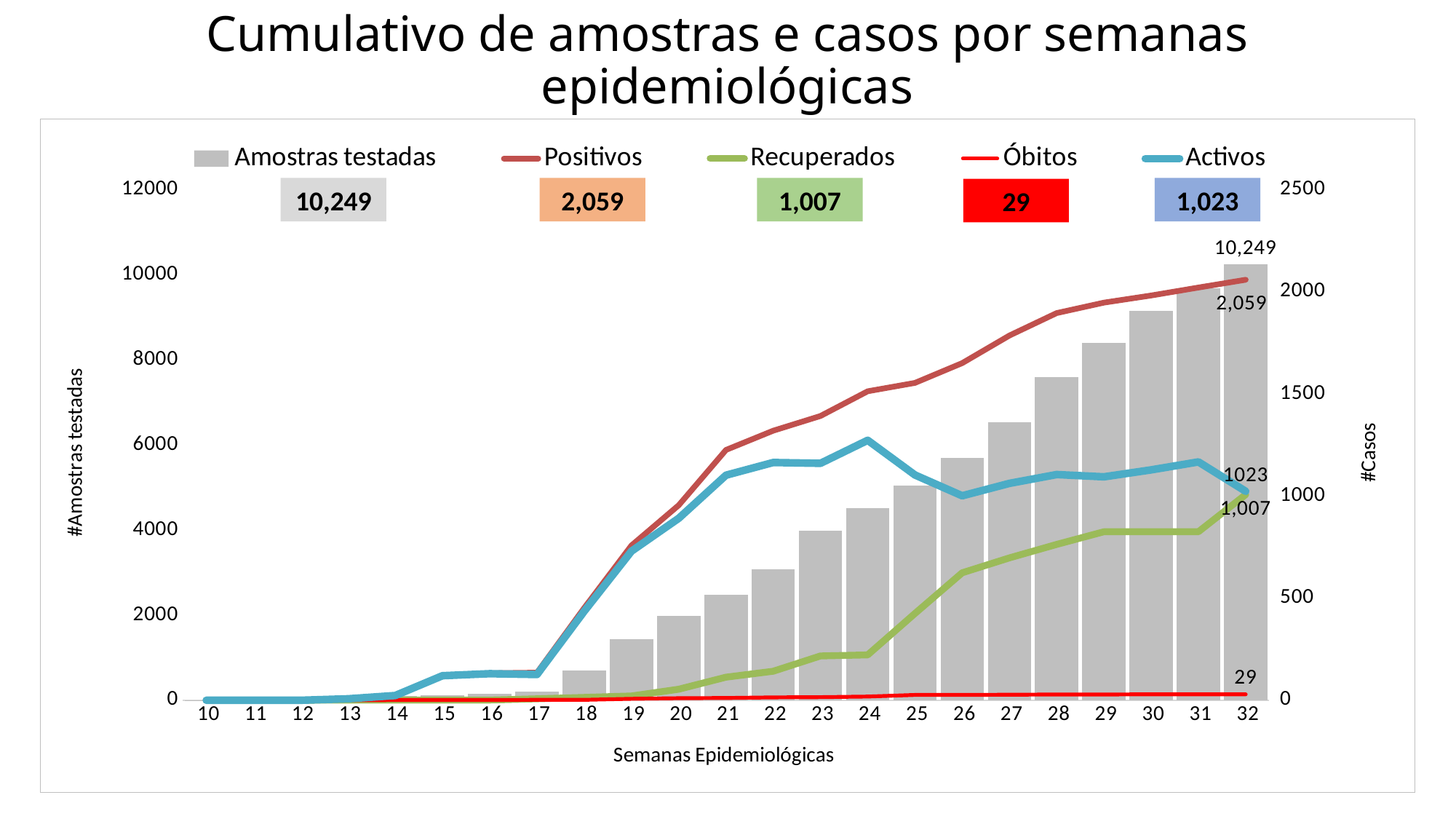
Do the Amostras testadas bars rise or fall from week 10 to week 32? Rise What is the difference between Positivos and Recuperados at week 32? 1,052 Is the value of Amostras testadas at week 25 greater or less than 4000? greater How many series does the legend list? 5 What is the value of Recuperados at week 32? 1,007 What is the value of Óbitos at week 32? 29 What is the value of Amostras testadas at week 32? 10,249 What is the difference between Amostras testadas and Positivos at week 32? 8,190 How many epidemiological weeks are shown on the x axis? 23 At week 32, which is larger: Positivos or Recuperados? Positivos What kind of chart is this? Combined bar and line chart What is the value of Positivos at week 32? 2,059